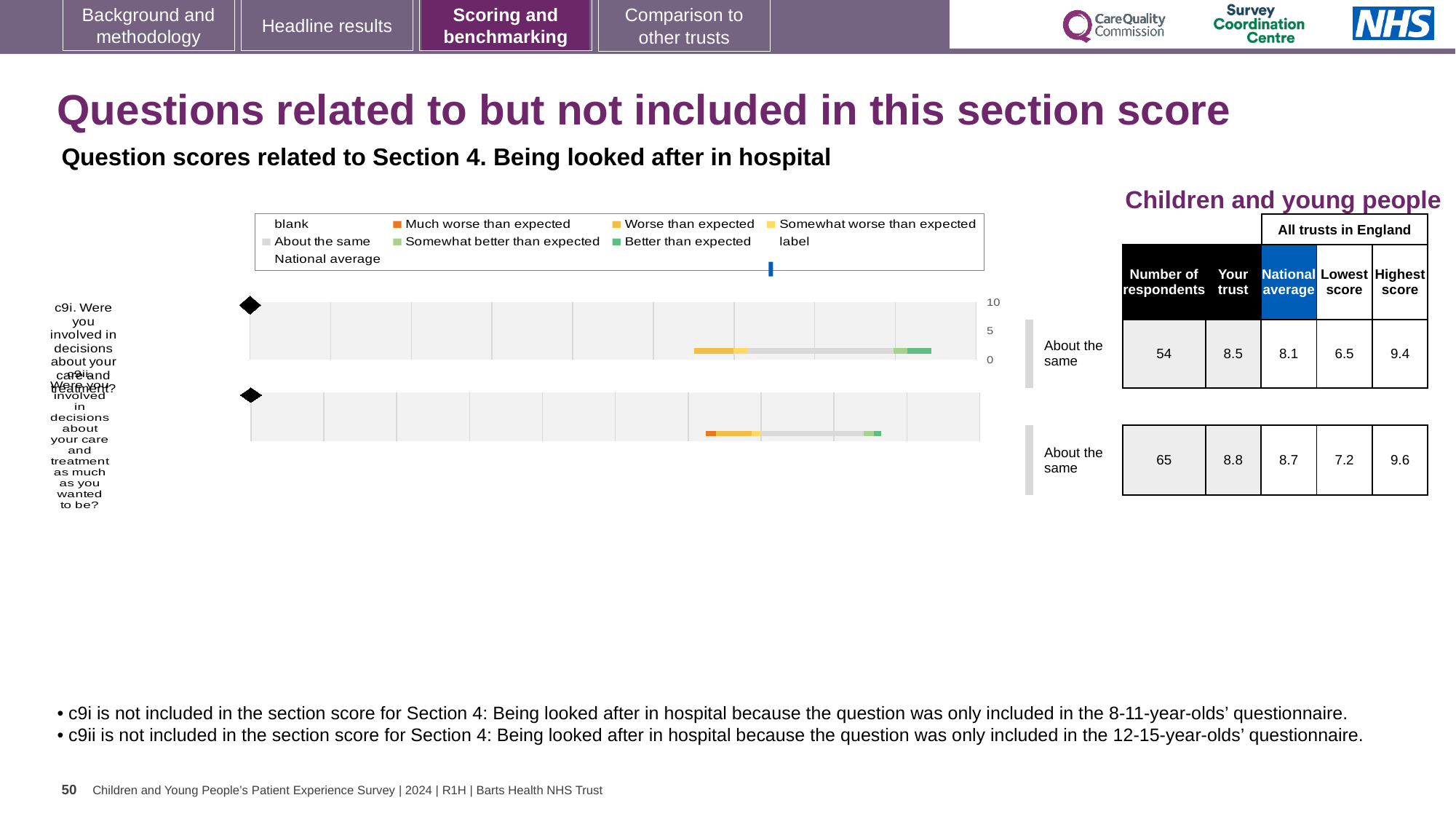
What benchmark category label is shown next to the chart for question c9i? About the same For question c9i, what is the national average score? 8.1 How many questions (c9i and c9ii) are plotted in the benchmarking charts on this slide? 2 Which question has the higher 'Your trust' score, c9i or c9ii? c9ii What kind of chart is used to show the question scores for c9i and c9ii? bar chart For question c9ii, what is the 'Your trust' score shown in the table beside the chart? 8.8 For question c9i, what is the 'Your trust' score shown in the table beside the chart? 8.5 What is the lowest score across all trusts in England for question c9i? 6.5 What is the difference between the highest and lowest scores across all trusts in England for question c9ii? 2.4 What is the highest score across all trusts in England for question c9ii? 9.6 What is the difference between the 'Your trust' score and the national average for question c9i? 0.4 For question c9ii, how many respondents are listed? 65